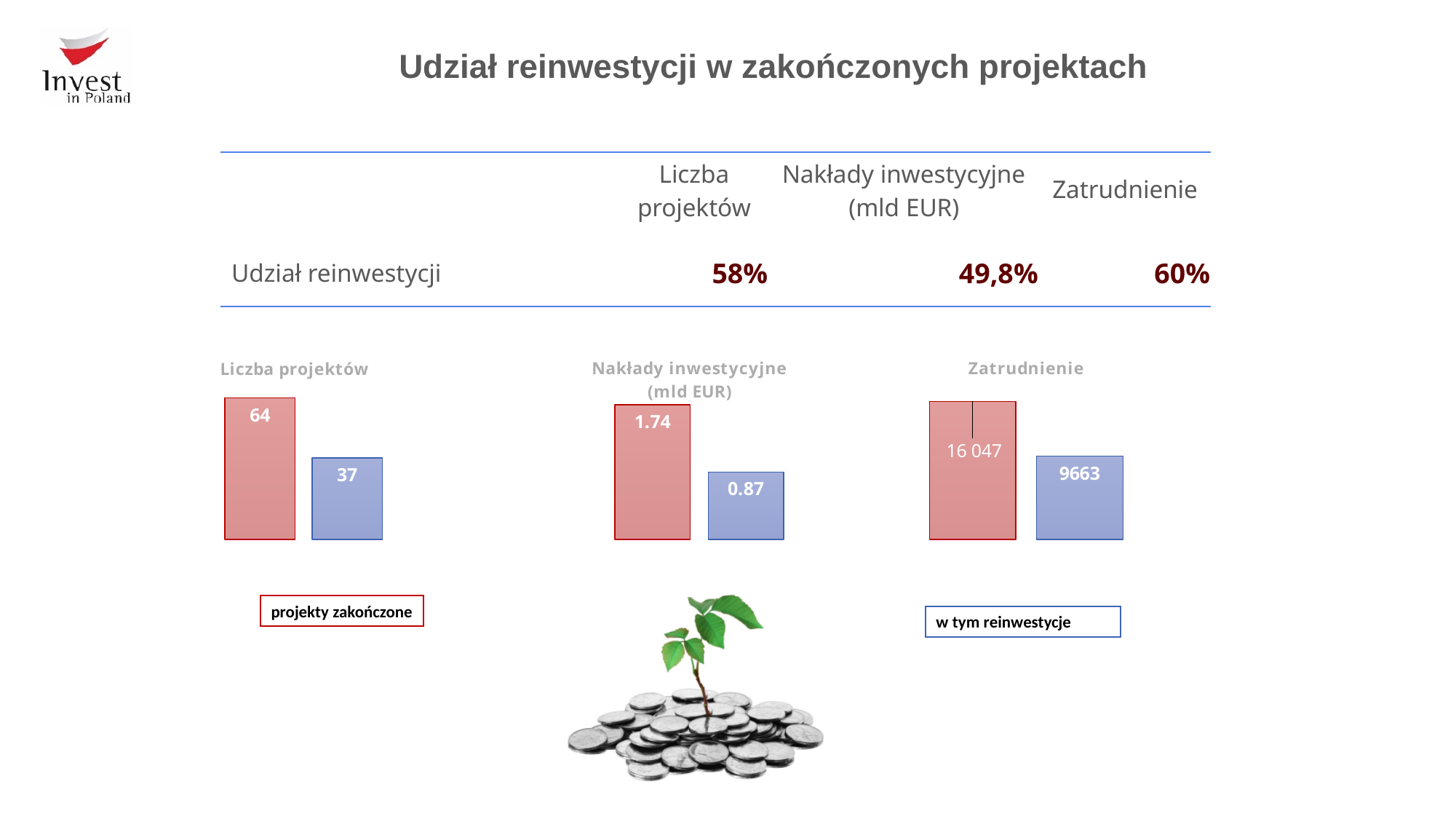
What kind of chart is the 'Liczba projektów' chart? bar chart In the 'Nakłady inwestycyjne (mld EUR)' chart, what is the value for projekty zakończone? 1.74 How many bars does the 'Nakłady inwestycyjne (mld EUR)' chart have? 2 In the 'Liczba projektów' chart, what is the difference between projekty zakończone and w tym reinwestycje? 27 In the 'Liczba projektów' chart, what is the value for w tym reinwestycje? 37 In the 'Liczba projektów' chart, what is the value for projekty zakończone? 64 In the 'Nakłady inwestycyjne (mld EUR)' chart, what is the difference between projekty zakończone and w tym reinwestycje? 0.87 In the 'Nakłady inwestycyjne (mld EUR)' chart, what is the value for w tym reinwestycje? 0.87 In the 'Zatrudnienie' chart, what is the value for projekty zakończone? 16 047 In the 'Zatrudnienie' chart, which bar is larger, projekty zakończone or w tym reinwestycje? projekty zakończone In the 'Zatrudnienie' chart, what is the difference between projekty zakończone and w tym reinwestycje? 6 384 In the 'Zatrudnienie' chart, what is the value for w tym reinwestycje? 9663